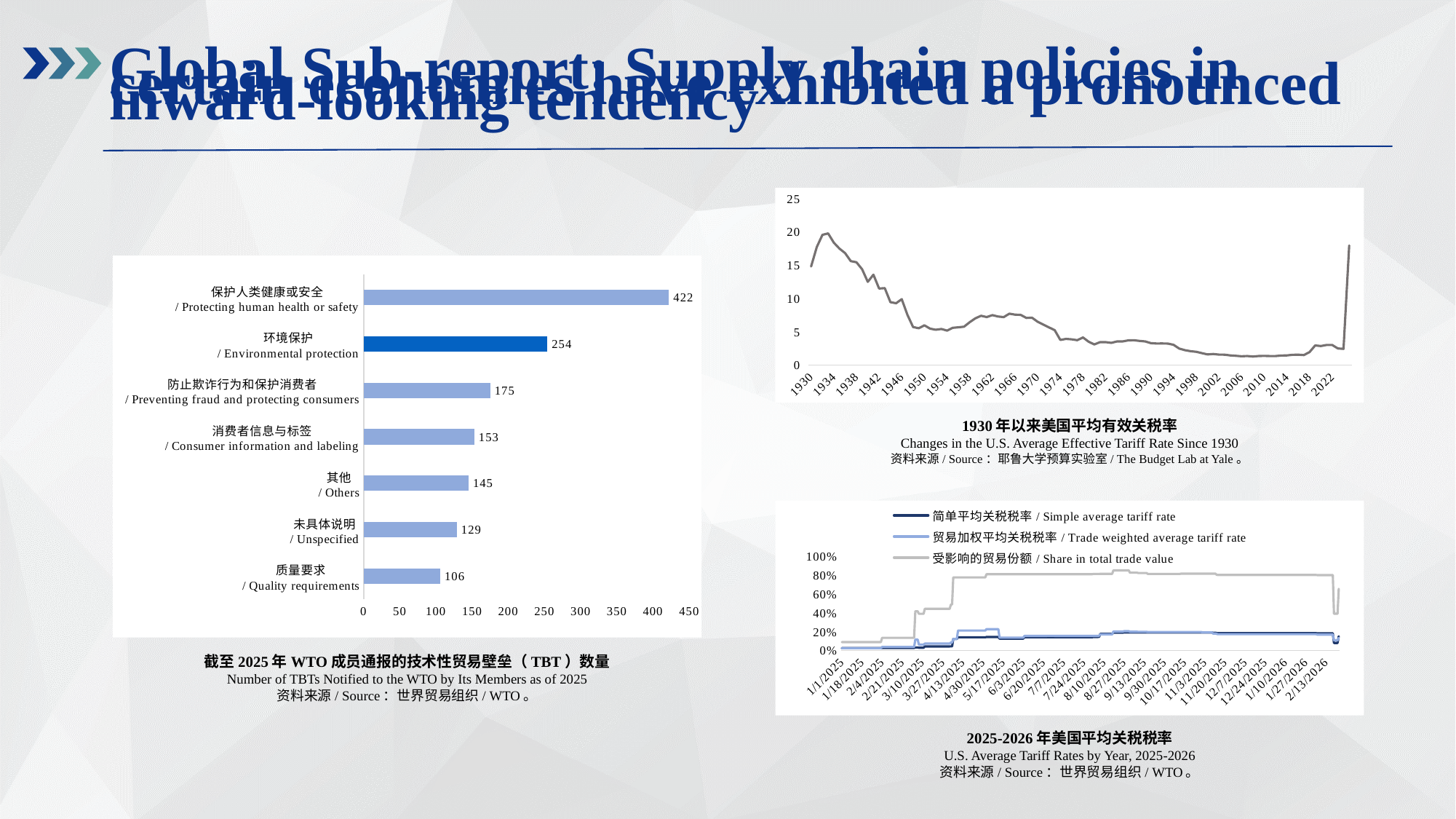
In the bar chart titled 'Number of TBTs Notified to the WTO by Its Members as of 2025', what is the value for Protecting human health or safety? 422 What kind of chart is the chart titled 'Number of TBTs Notified to the WTO by Its Members as of 2025'? Bar chart How many series does the legend list in the chart titled 'U.S. Average Tariff Rates by Year, 2025-2026'? 3 In the bar chart titled 'Number of TBTs Notified to the WTO by Its Members as of 2025', what is the value for Environmental protection? 254 In the chart titled 'Changes in the U.S. Average Effective Tariff Rate Since 1930', is the value for 1934 greater or less than 15? greater In the bar chart titled 'Number of TBTs Notified to the WTO by Its Members as of 2025', what is the difference between Protecting human health or safety and Environmental protection? 168 In the bar chart titled 'Number of TBTs Notified to the WTO by Its Members as of 2025', how many categories are shown? 7 In the bar chart titled 'Number of TBTs Notified to the WTO by Its Members as of 2025', which is larger: Consumer information and labeling or Others? Consumer information and labeling In the chart titled 'U.S. Average Tariff Rates by Year, 2025-2026', is the value of Share in total trade value at 8/27/2025 greater or less than 60%? greater In the chart titled 'Changes in the U.S. Average Effective Tariff Rate Since 1930', is the value for 2010 greater or less than 5? less In the bar chart titled 'Number of TBTs Notified to the WTO by Its Members as of 2025', which category has the lowest value? Quality requirements In the bar chart titled 'Number of TBTs Notified to the WTO by Its Members as of 2025', which category has the highest value? Protecting human health or safety